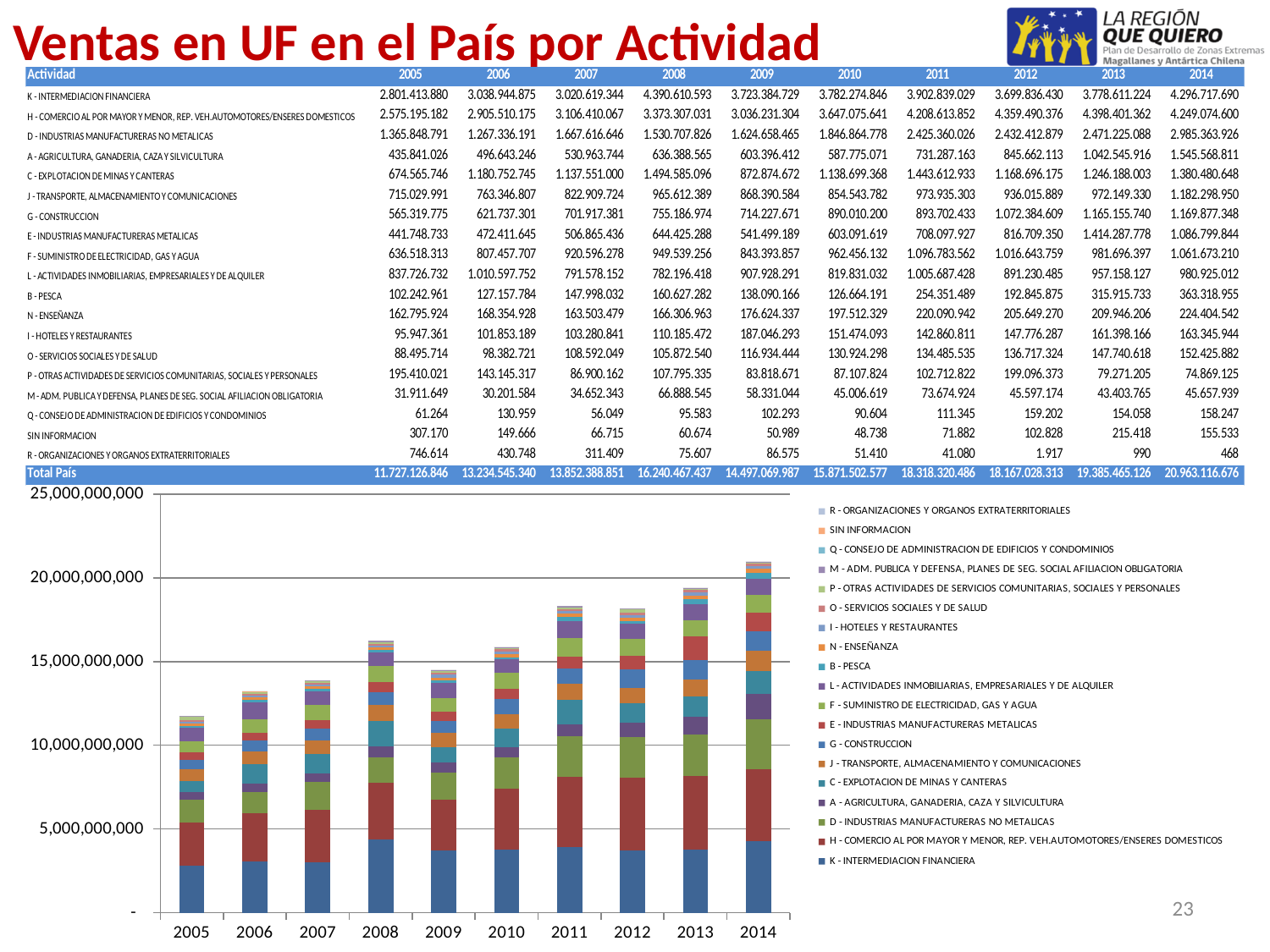
Is the total bar for 2014 greater or less than 20,000,000,000? greater What kind of chart is shown on the slide? Stacked bar chart Is the total bar for 2005 greater or less than 15,000,000,000? less How many series does the chart legend list? 19 Which year has the lowest total bar in the chart? 2005 What is the Total País value for 2014? 20.963.116.676 What is the difference between the Total País for 2014 and for 2005? 9.235.989.830 How many years are shown on the x axis of the chart? 10 Which year has the larger total bar, 2012 or 2013? 2013 Which series forms the bottom segment of each stacked bar? K - INTERMEDIACION FINANCIERA What is the Total País value for 2005? 11.727.126.846 Which year has the highest total bar in the chart? 2014